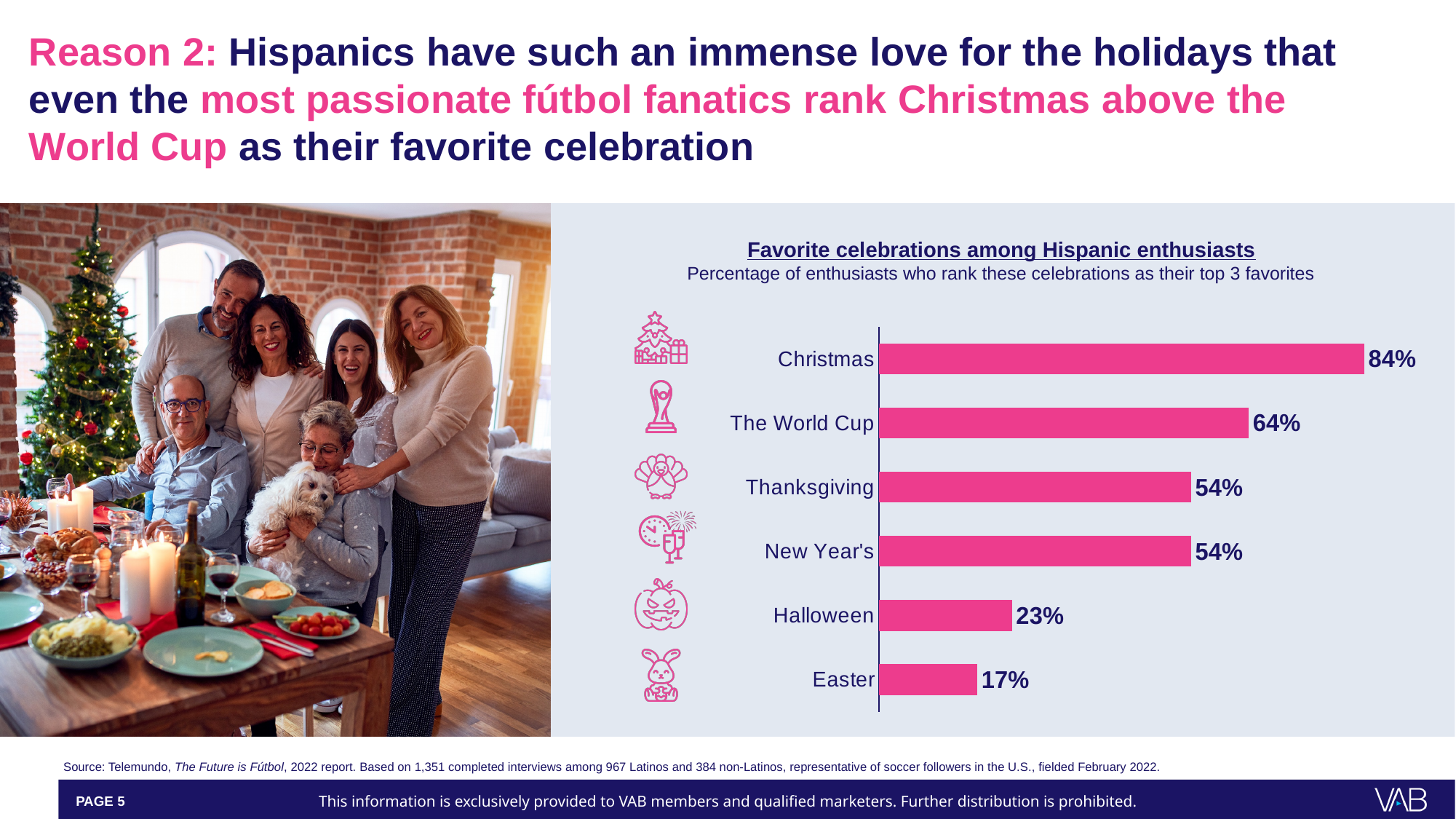
How many celebrations are shown in the chart? 6 Which celebration has the lowest percentage in the chart? Easter What is the title of the chart? Favorite celebrations among Hispanic enthusiasts Which celebration has the highest percentage in the chart? Christmas What is the difference in percentage points between Halloween and Easter? 6 What is the value shown for Halloween? 23% What is the value shown for The World Cup? 64% What is the difference in percentage points between Christmas and The World Cup? 20 Do the values rise or fall going from the top bar to the bottom bar? Fall What percentage of Hispanic enthusiasts rank Christmas among their top 3 favorite celebrations? 84% What kind of chart is used to show favorite celebrations? Bar chart Which has a higher value, Thanksgiving or Halloween? Thanksgiving